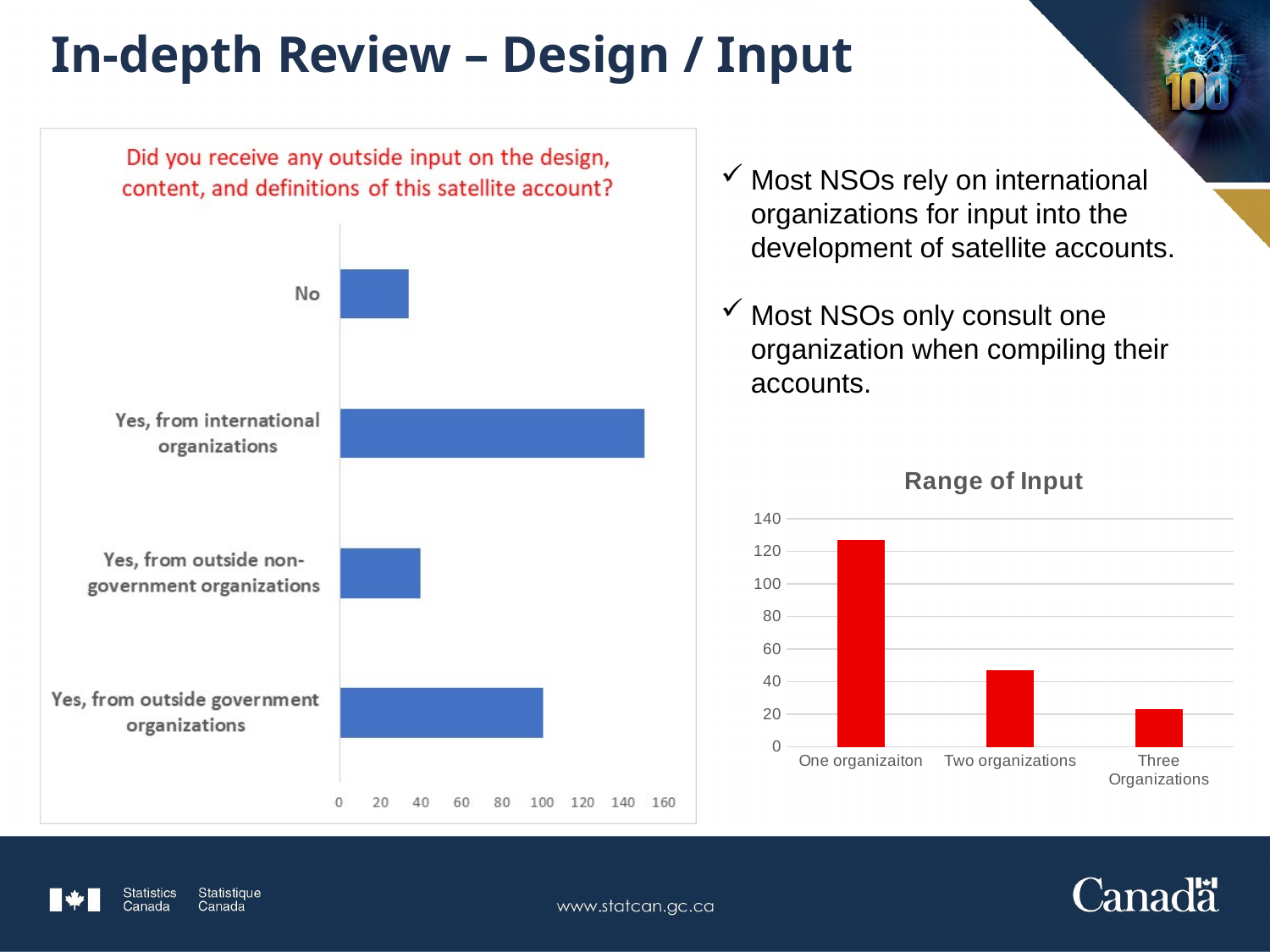
In the "Range of Input" chart, which category has the highest value? One organizaiton In the "Range of Input" chart, is the value for "One organizaiton" greater or less than 120? greater In the chart titled "Did you receive any outside input on the design, content, and definitions of this satellite account?", how many categories are plotted? 4 In the chart titled "Did you receive any outside input on the design, content, and definitions of this satellite account?", what kind of chart is shown? Bar chart In the chart titled "Did you receive any outside input on the design, content, and definitions of this satellite account?", which category has the lowest value? No In the chart titled "Did you receive any outside input on the design, content, and definitions of this satellite account?", which is larger: "Yes, from outside government organizations" or "Yes, from outside non-government organizations"? Yes, from outside government organizations In the "Range of Input" chart, what kind of chart is shown? Bar chart In the chart titled "Did you receive any outside input on the design, content, and definitions of this satellite account?", which category has the highest value? Yes, from international organizations In the "Range of Input" chart, do the values rise or fall from left to right along the x axis? Fall In the chart titled "Did you receive any outside input on the design, content, and definitions of this satellite account?", is the value for "Yes, from international organizations" greater or less than 140? greater In the chart titled "Did you receive any outside input on the design, content, and definitions of this satellite account?", is the value for "No" greater or less than 40? less In the "Range of Input" chart, how many categories are plotted? 3